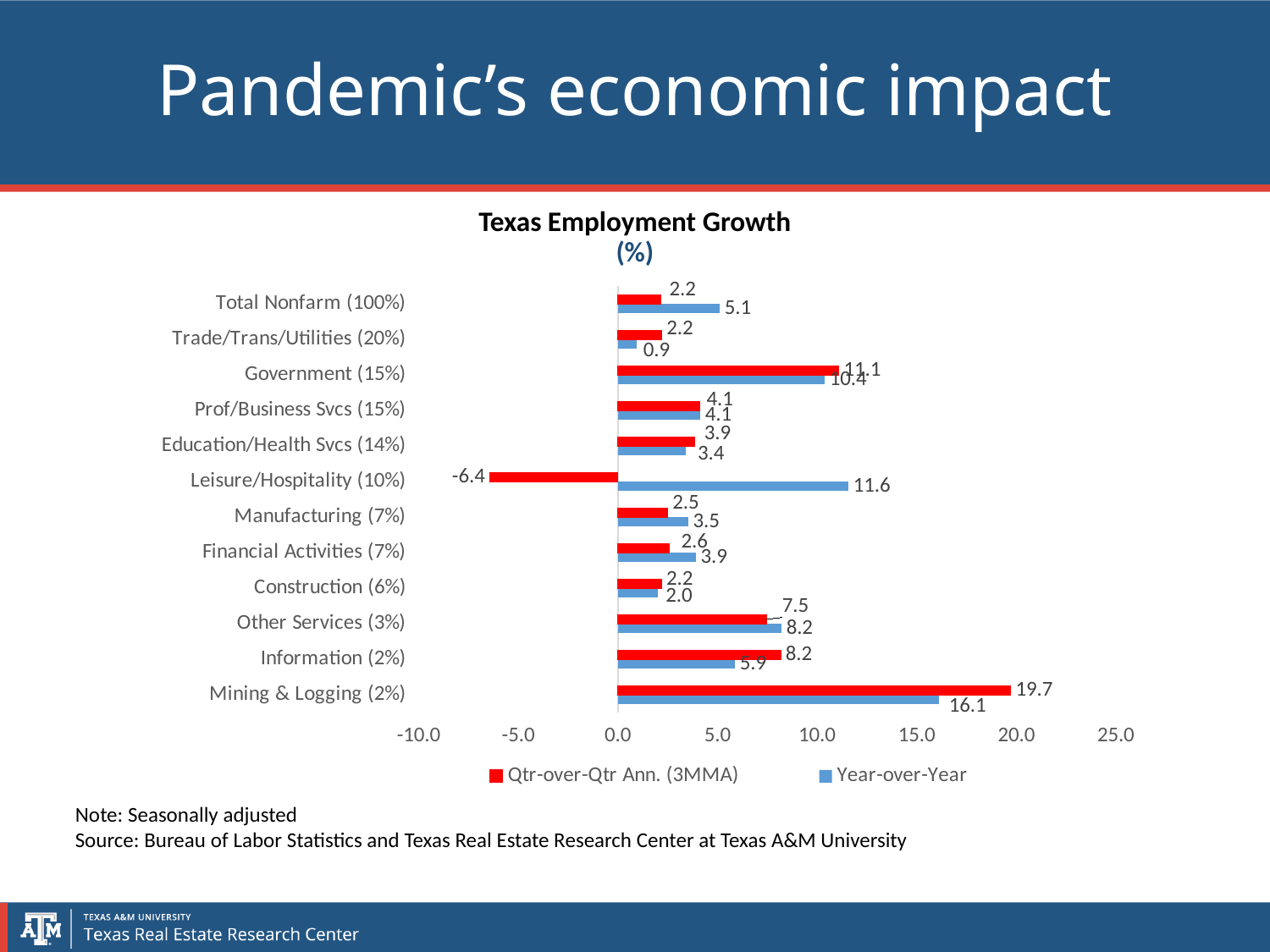
Which category has the lowest Year-over-Year value? Trade/Trans/Utilities (20%) What kind of chart is shown on the slide? Bar chart What is the difference between the Year-over-Year and Qtr-over-Qtr Ann. (3MMA) values for Leisure/Hospitality (10%)? 18.0 How many categories are shown on the chart? 12 What is the title of the chart? Texas Employment Growth (%) What is the Qtr-over-Qtr Ann. (3MMA) value for Leisure/Hospitality (10%)? -6.4 What is the Year-over-Year value for Total Nonfarm (100%)? 5.1 Which category has the highest Qtr-over-Qtr Ann. (3MMA) value? Mining & Logging (2%) Is the Year-over-Year value for Other Services (3%) greater or less than 5.0? greater What is the Year-over-Year value for Mining & Logging (2%)? 16.1 Which is larger for Information (2%): the Qtr-over-Qtr Ann. (3MMA) value or the Year-over-Year value? Qtr-over-Qtr Ann. (3MMA) How many series does the legend list? 2